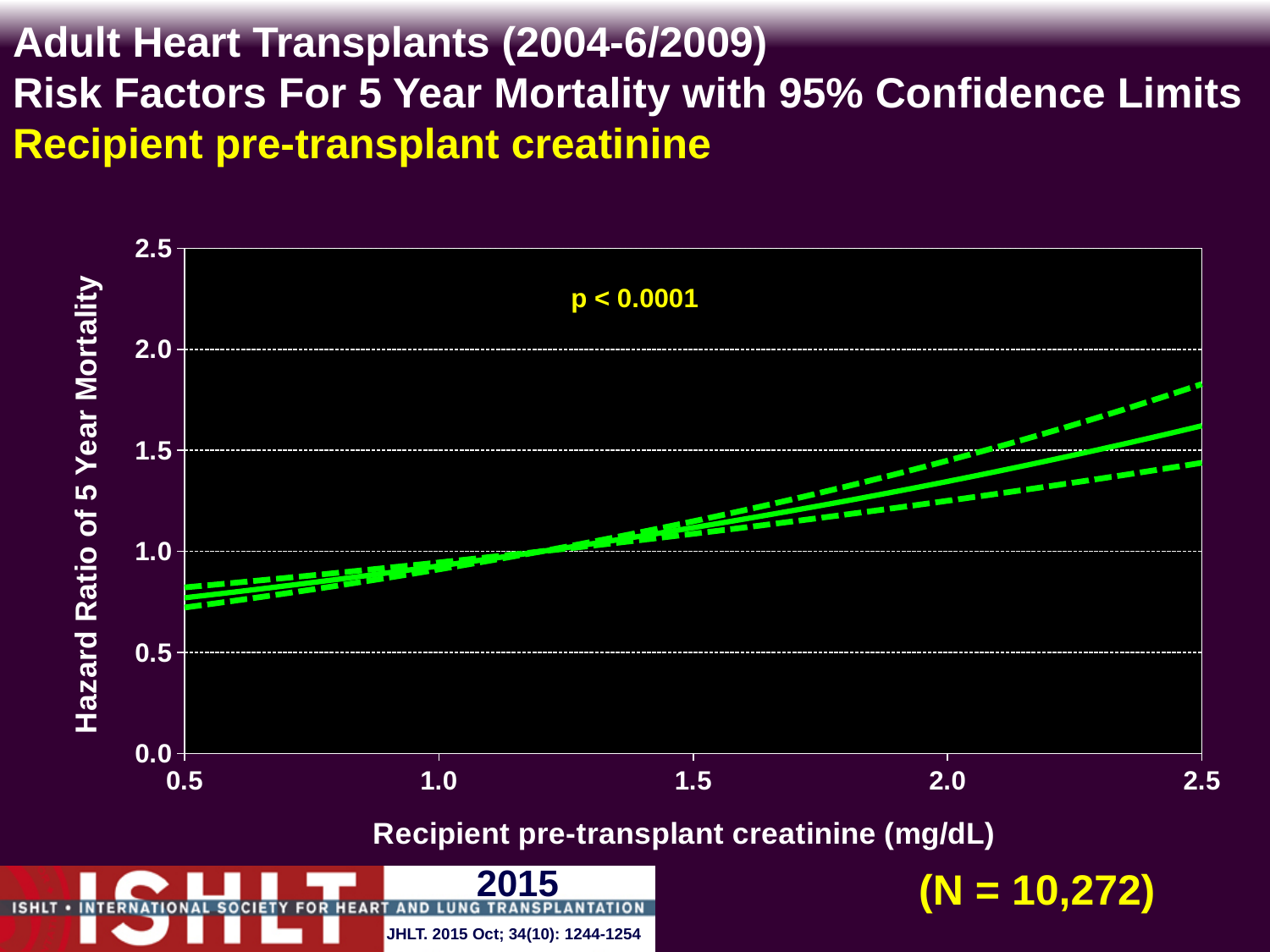
Which is larger for the solid line: the hazard ratio at a creatinine of 0.5 mg/dL or at 2.5 mg/dL? 2.5 mg/dL How many lines are plotted on the chart? 3 Is the lower confidence limit at a creatinine of 2.5 mg/dL greater or less than 1.5? less What p-value is printed on the chart? p < 0.0001 Is the hazard ratio for the solid line at a creatinine of 2.0 mg/dL greater or less than 1.5? less Is the upper confidence limit at a creatinine of 2.5 mg/dL greater or less than 1.5? greater What kind of chart is shown on the slide? line chart What is the label of the x axis? Recipient pre-transplant creatinine (mg/dL) Does the hazard ratio of 5 year mortality rise or fall as recipient pre-transplant creatinine increases? rise